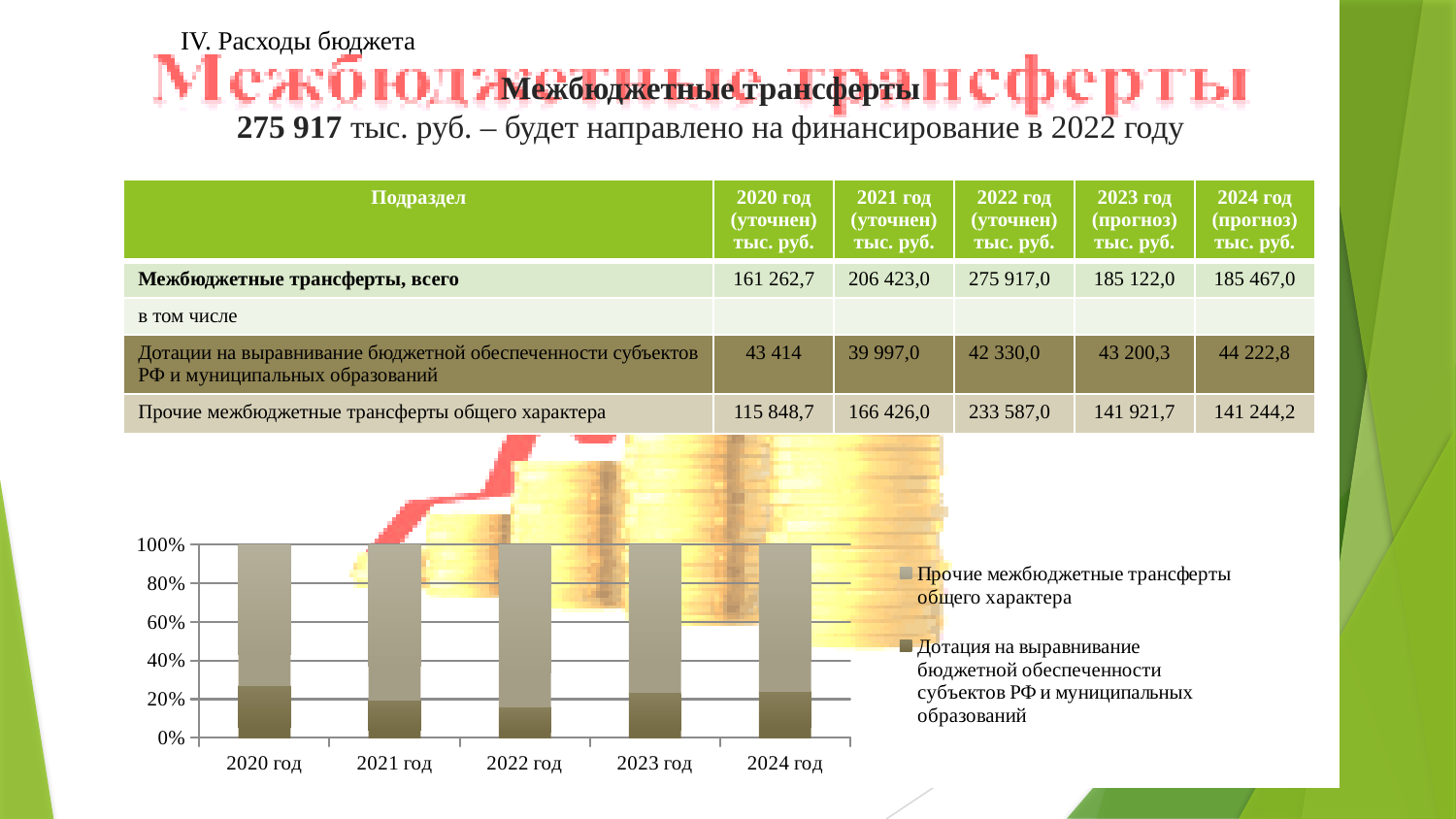
Is the share of "Дотация на выравнивание бюджетной обеспеченности" in 2022 год greater or less than 20%? less Does the share of "Дотация на выравнивание бюджетной обеспеченности" rise or fall from 2020 год to 2022 год? fall Which is larger in 2022 год: the share of "Прочие межбюджетные трансферты общего характера" or the share of "Дотация на выравнивание бюджетной обеспеченности"? Прочие межбюджетные трансферты общего характера Is the share of "Дотация на выравнивание бюджетной обеспеченности" in 2020 год greater or less than 20%? greater What kind of chart is shown on the slide? stacked bar chart Which year has the smallest share for "Дотация на выравнивание бюджетной обеспеченности субъектов РФ и муниципальных образований"? 2022 год Which year has the larger share for "Дотация на выравнивание бюджетной обеспеченности": 2020 год or 2022 год? 2020 год What is the highest value shown on the chart's y axis? 100% How many years are shown on the x axis of the chart? 5 How many series does the chart legend list? 2 Which series is shown in the darker colour at the bottom of each bar? Дотация на выравнивание бюджетной обеспеченности субъектов РФ и муниципальных образований Is the share of "Прочие межбюджетные трансферты общего характера" in 2022 год greater or less than 80%? greater